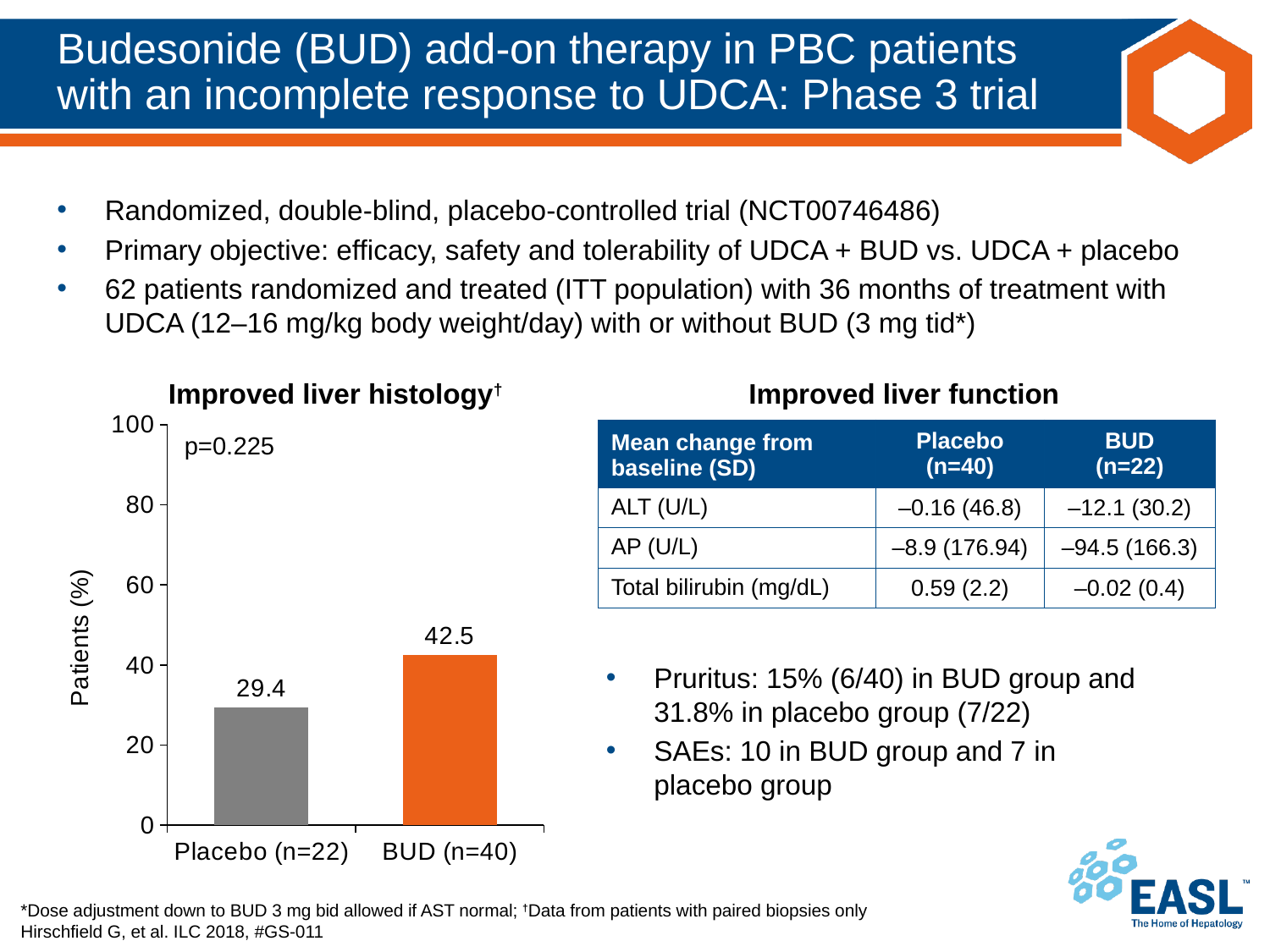
Is the value for BUD (n=40) greater or less than 60? less What p-value is shown on the Improved liver histology chart? p=0.225 What kind of chart is used to show improved liver histology? bar chart How many categories are shown on the x axis of the Improved liver histology chart? 2 Is the value for BUD (n=40) larger or smaller than the value for Placebo (n=22)? larger Which group has the higher percentage of patients with improved liver histology? BUD (n=40) What is the value for BUD (n=40) in the Improved liver histology chart? 42.5 What is the y-axis label of the Improved liver histology chart? Patients (%) What is the value for Placebo (n=22) in the Improved liver histology chart? 29.4 What is the difference between the BUD (n=40) and Placebo (n=22) values in the Improved liver histology chart? 13.1 Which group has the lower percentage of patients with improved liver histology? Placebo (n=22) Is the value for Placebo (n=22) greater or less than 40? less